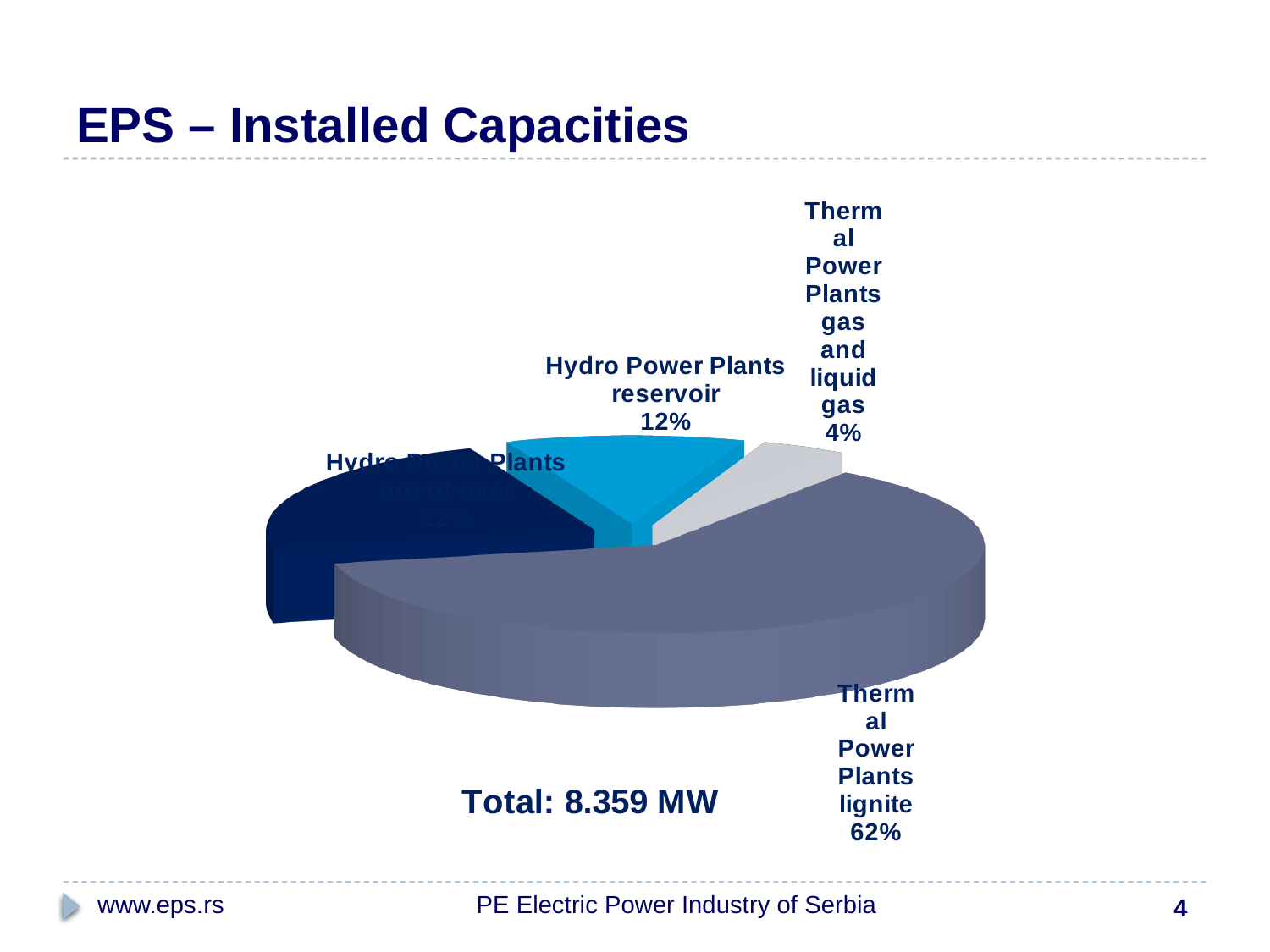
What share of installed capacity do Hydro Power Plants run-of-river account for? 22% What share of installed capacity do Thermal Power Plants lignite account for? 62% What share of installed capacity do Thermal Power Plants gas and liquid gas account for? 4% What is the title of the slide containing the pie chart? EPS – Installed Capacities What is the difference in percentage points between Thermal Power Plants lignite and Hydro Power Plants reservoir? 50 Which category has the smallest slice of the pie? Thermal Power Plants gas and liquid gas What total installed capacity is stated below the pie chart? 8.359 MW What kind of chart is shown on the slide? pie chart How many slices does the pie chart have? 4 Which is larger, the share for Hydro Power Plants reservoir or the share for Thermal Power Plants gas and liquid gas? Hydro Power Plants reservoir Which category has the largest slice of the pie? Thermal Power Plants lignite